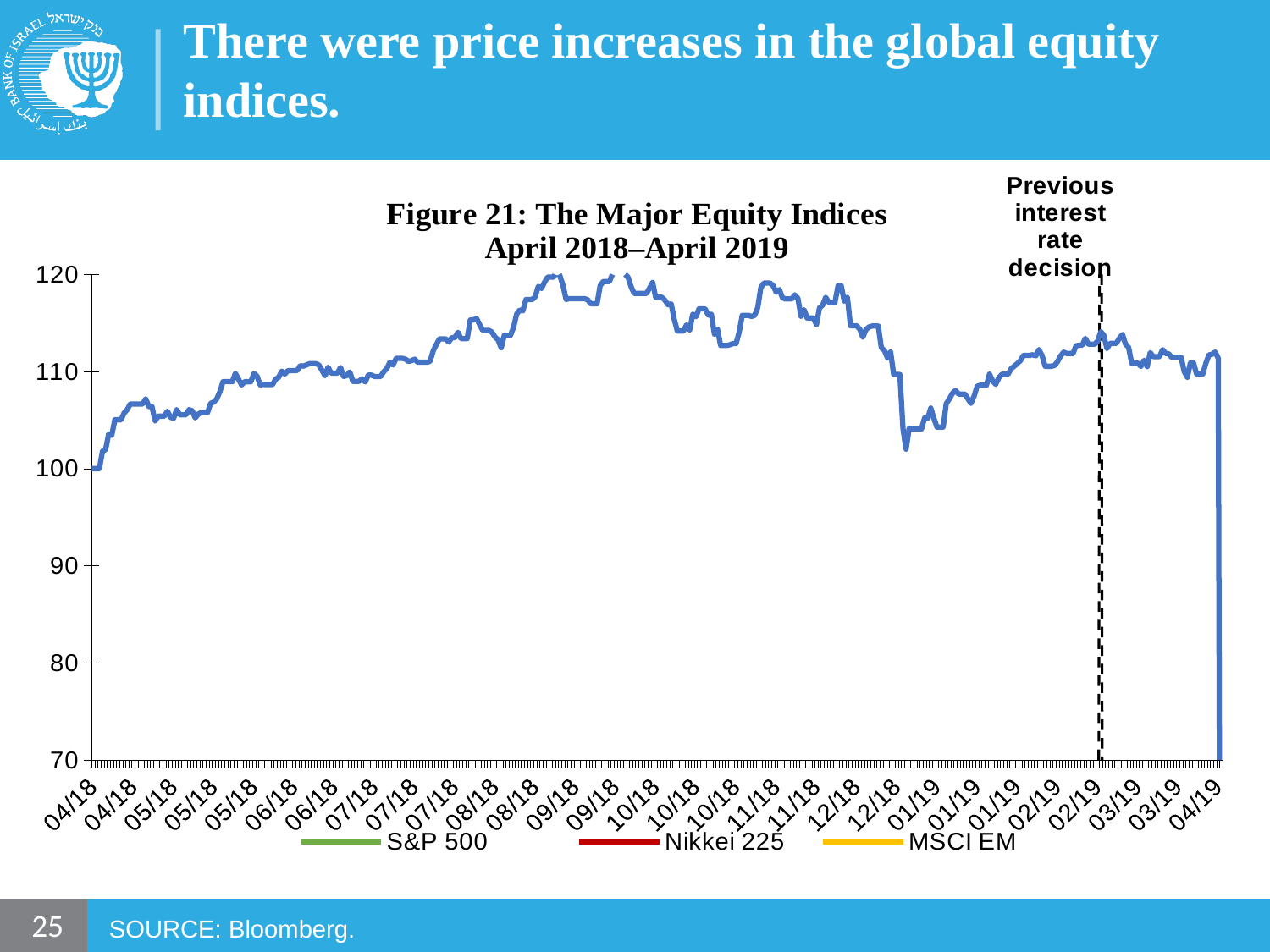
What does the dashed vertical line in Figure 21 mark? Previous interest rate decision Is the value of the plotted line at 02/19 greater or less than 110? greater Does the plotted line rise or fall between 10/18 and late 12/18? fall Which is larger, the value of the plotted line at 09/18 or at 01/19? 09/18 Is the value of the plotted line at the dip in late 12/18 greater or less than 110? less What kind of chart is Figure 21? line chart How many series does the legend of Figure 21 list? 3 Is the value of the plotted line at 09/18 greater or less than 110? greater Does the plotted line rise or fall between 04/18 and 09/18? rise What is the value of the plotted line at the start of the chart in 04/18? 100 What is the title of the chart on the slide? Figure 21: The Major Equity Indices April 2018–April 2019